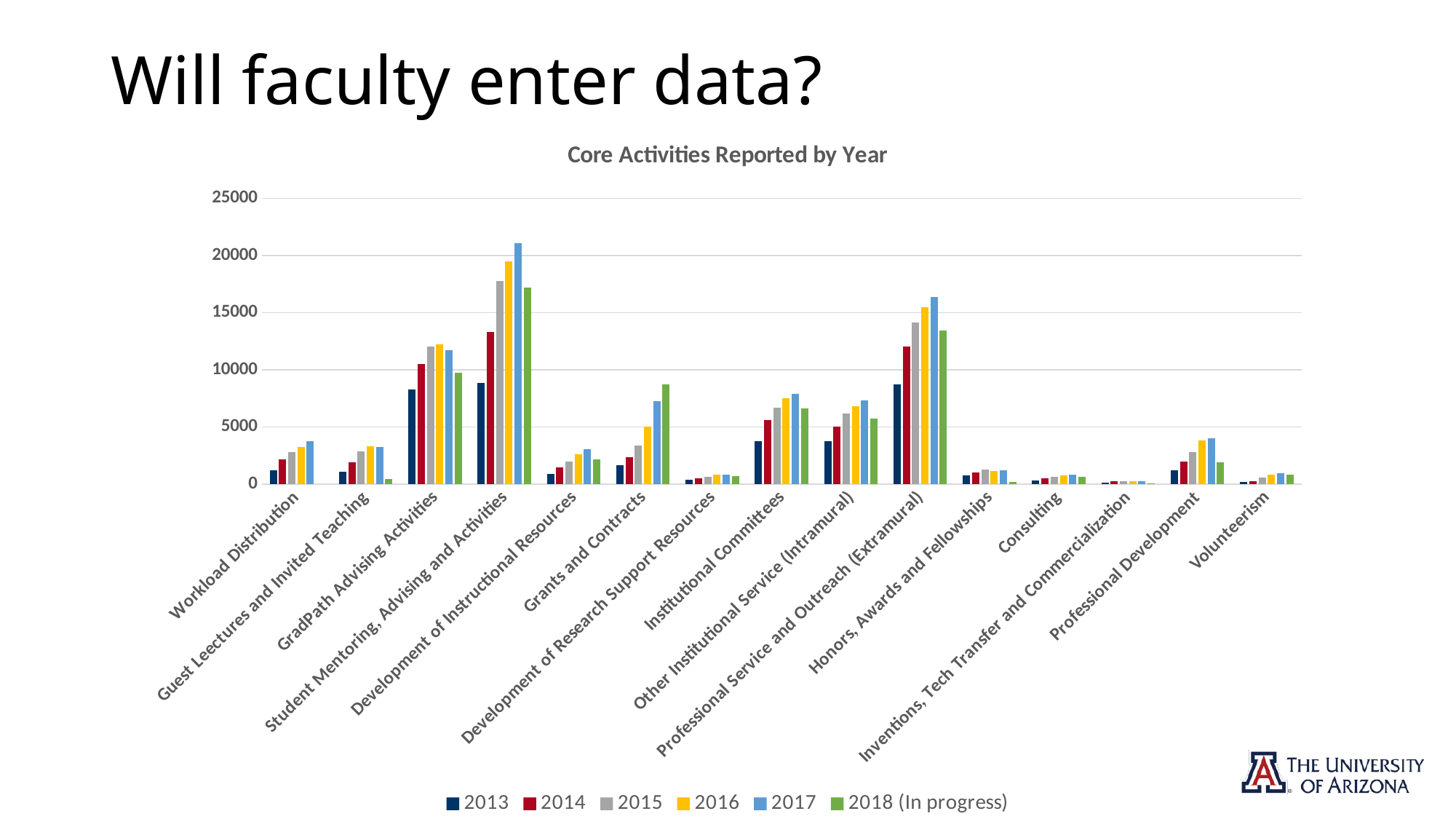
What kind of chart is shown on the slide? bar chart Which category has the lowest values across all years? Inventions, Tech Transfer and Commercialization What is the title of the chart? Core Activities Reported by Year For Student Mentoring, Advising and Activities, do the values rise or fall from 2013 to 2017? rise Is the 2017 value for Professional Service and Outreach (Extramural) greater or less than 15000? greater For Grants and Contracts, which is larger, the 2017 value or the 2018 (In progress) value? 2018 (In progress) For Workload Distribution, which is larger, the 2013 value or the 2017 value? 2017 How many series does the legend list? 6 Is the 2013 value for GradPath Advising Activities greater or less than 5000? greater How many activity categories are shown on the x axis? 15 Is the 2017 value for Student Mentoring, Advising and Activities greater or less than 20000? greater Which category has the highest 2017 value? Student Mentoring, Advising and Activities